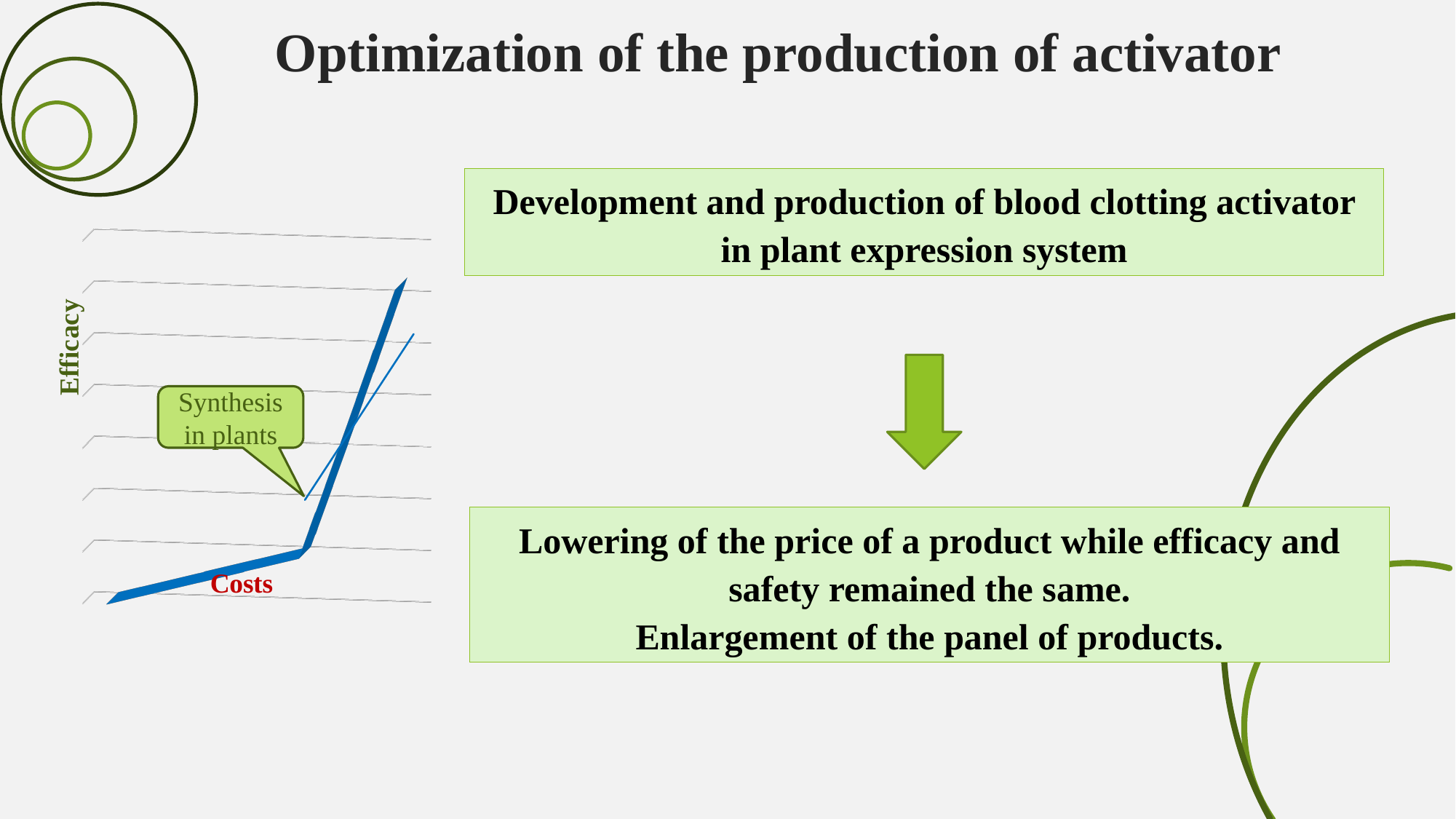
What is the label on the vertical axis of the chart on the left? Efficacy What kind of chart is shown on the left of the slide? line chart What is the label on the horizontal axis of the chart on the left? Costs In the chart on the left, do the plotted lines rise or fall as you move along the x axis? rise